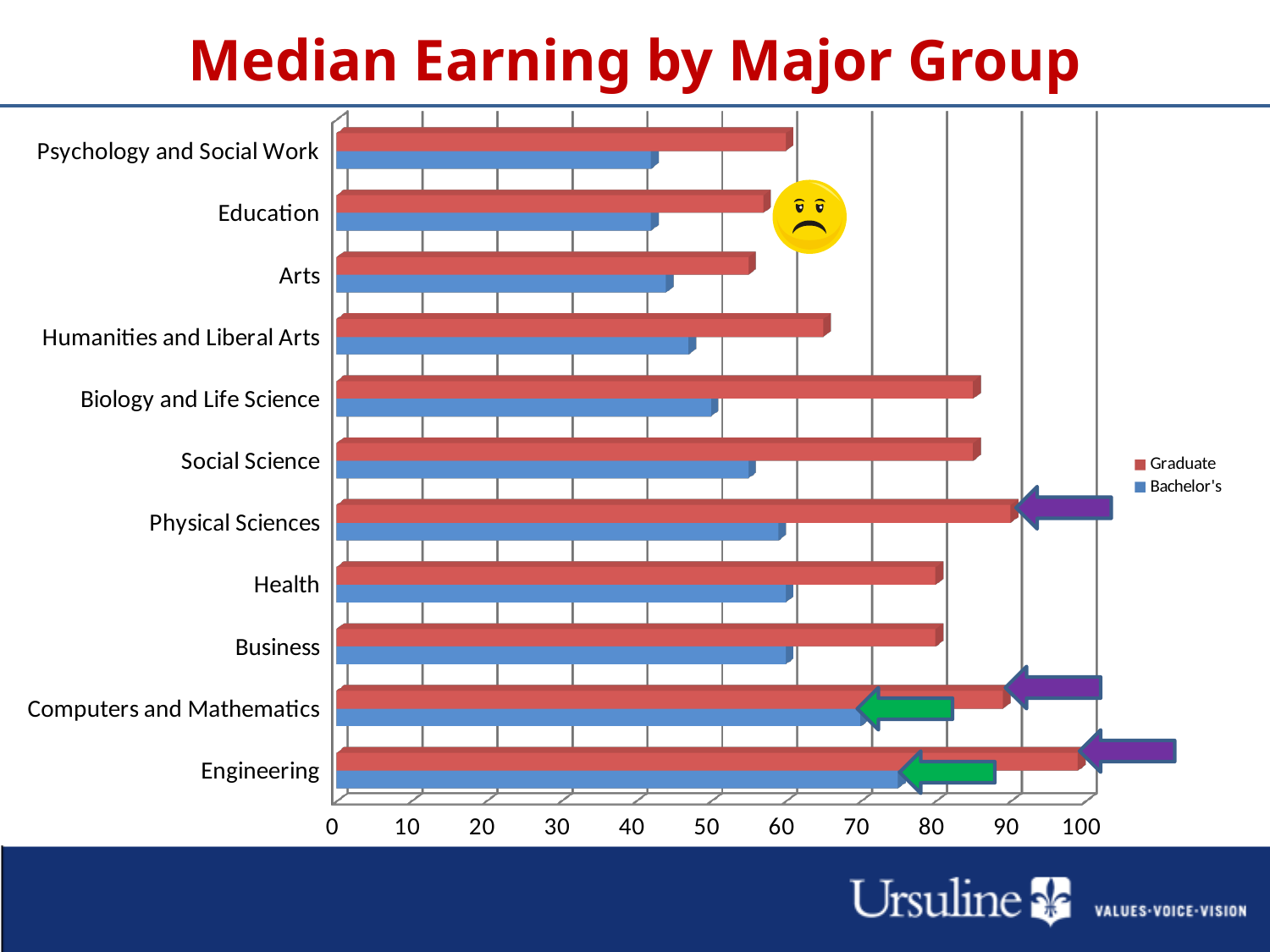
How many series does the legend list? 2 Is the Graduate value for Physical Sciences greater or less than 80? greater Is the Graduate value for Psychology and Social Work greater or less than 70? less Which is larger, the Graduate value for Physical Sciences or the Graduate value for Health? Physical Sciences Which major group has the highest Graduate median earning? Engineering Which major group has the highest Bachelor's median earning? Engineering How many major groups are listed on the chart? 11 Is the Bachelor's value for Biology and Life Science greater or less than 60? less What is the title of the chart? Median Earning by Major Group Which is larger, the Graduate value for Biology and Life Science or the Graduate value for Humanities and Liberal Arts? Biology and Life Science What kind of chart is shown on the slide? Bar chart